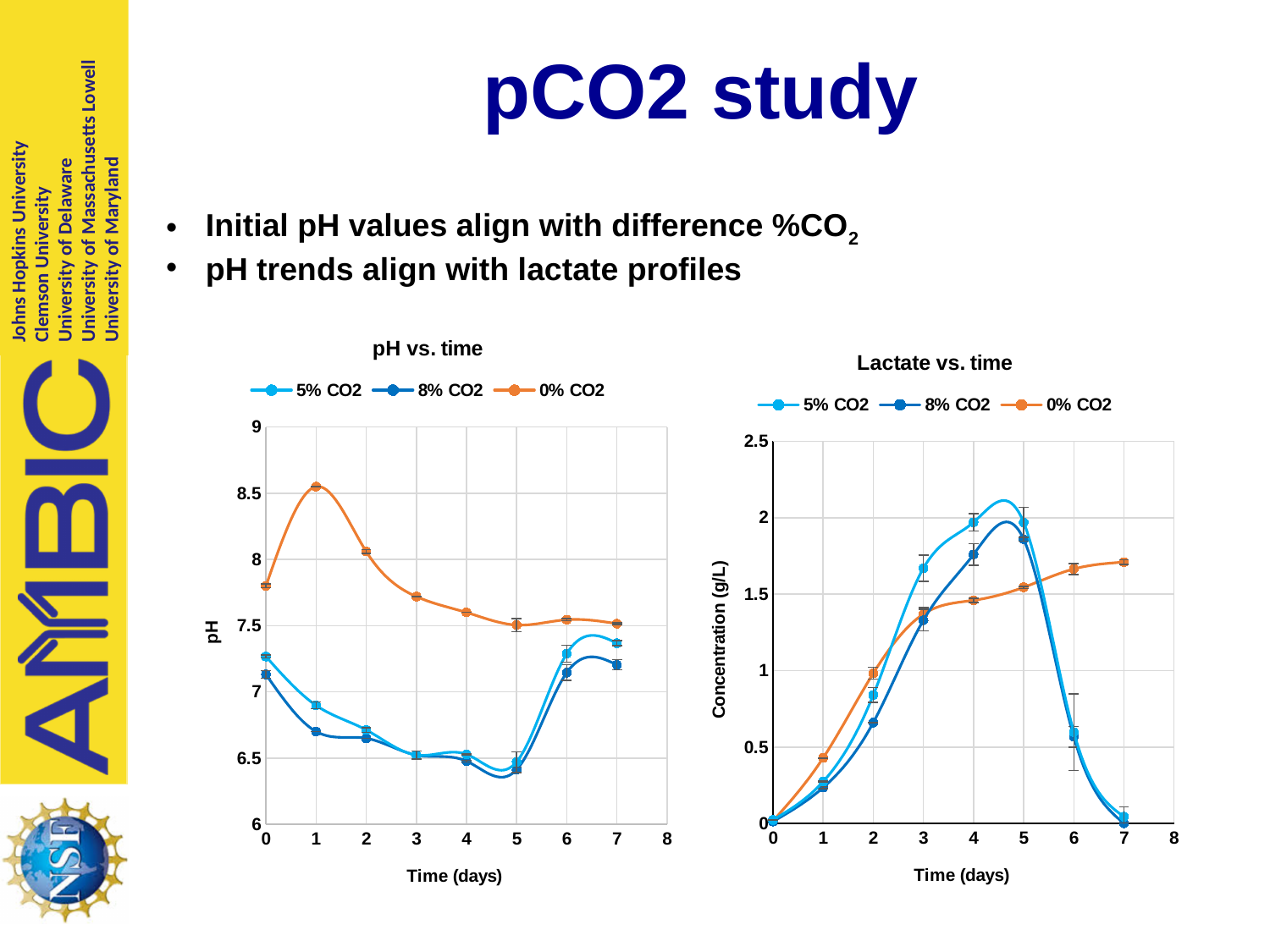
How many series does the legend of the "Lactate vs. time" chart list? 3 In the "Lactate vs. time" chart, does the concentration for 0% CO2 generally rise or fall from day 0 to day 7? rise What kind of chart is the "pH vs. time" chart? line chart In the "pH vs. time" chart, is the pH for 8% CO2 at day 5 greater or less than 6.5? less In the "pH vs. time" chart, is the pH for 0% CO2 at day 0 greater or less than 7.5? greater In the "Lactate vs. time" chart, which series has the highest concentration at day 4? 5% CO2 In the "Lactate vs. time" chart, is the concentration for 5% CO2 at day 4 greater or less than 1.5? greater In the "pH vs. time" chart, does the pH for 0% CO2 rise or fall between day 1 and day 5? fall What is the y-axis label of the "Lactate vs. time" chart? Concentration (g/L) In the "pH vs. time" chart, which series has the highest pH at day 1? 0% CO2 In the "Lactate vs. time" chart, which series has the highest concentration at day 7? 0% CO2